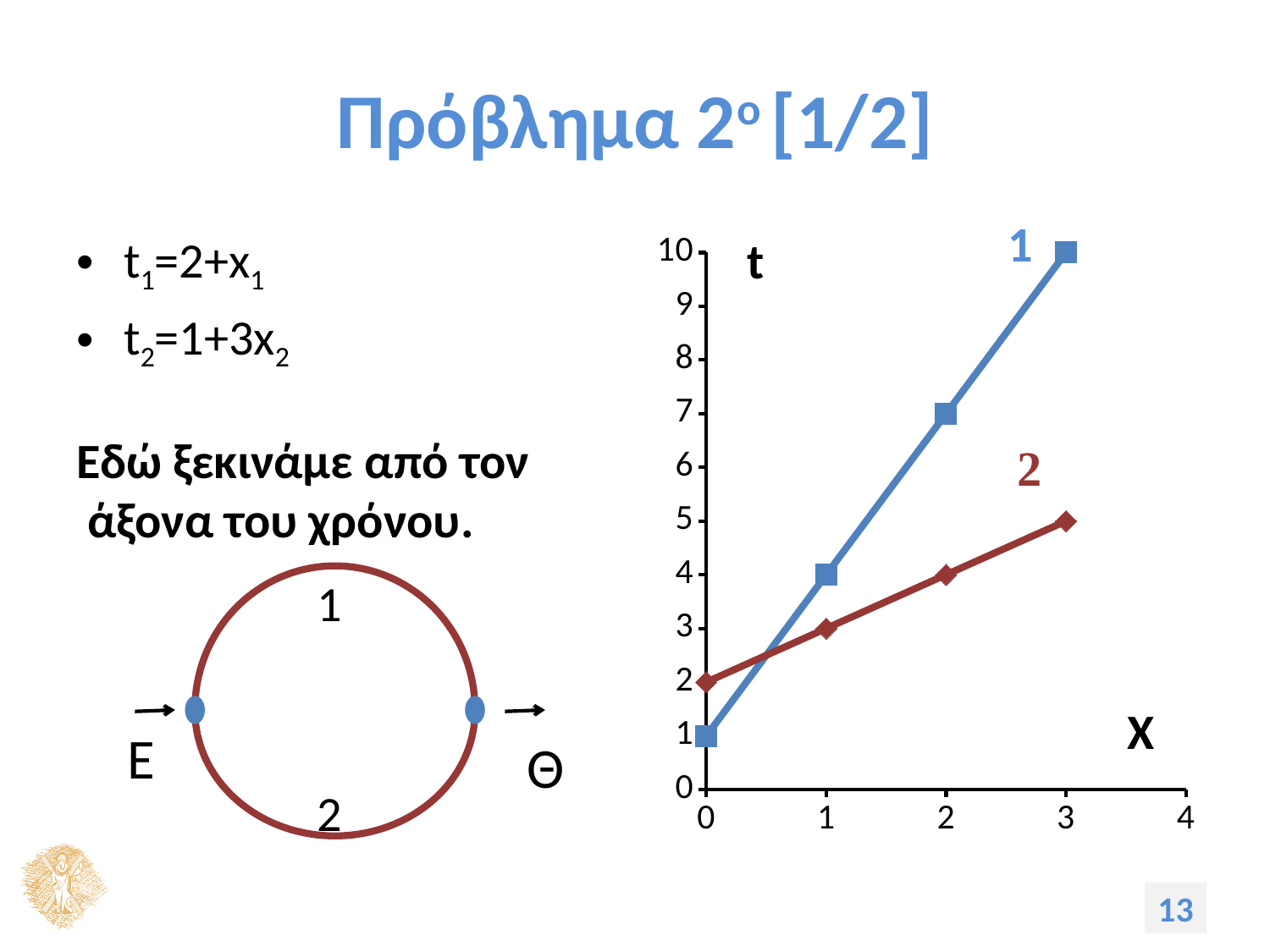
What kind of chart is shown on the slide? line chart What is the difference between the t values of series 1 and series 2 at x = 3? 5 What label is shown on the vertical axis of the chart? t How many data points does series 1 have on the chart? 4 At x = 0, which series has the higher value of t, series 1 or series 2? series 2 Does the value of t for series 1 rise or fall as x increases? rise What is the value of t for series 1 at x = 2? 7 What is the value of t for series 2 at x = 3? 5 What is the value of t for series 2 at x = 0? 2 What is the value of t for series 1 at x = 3? 10 How many series are plotted on the chart? 2 At x = 1, which series has the higher value of t, series 1 or series 2? series 1